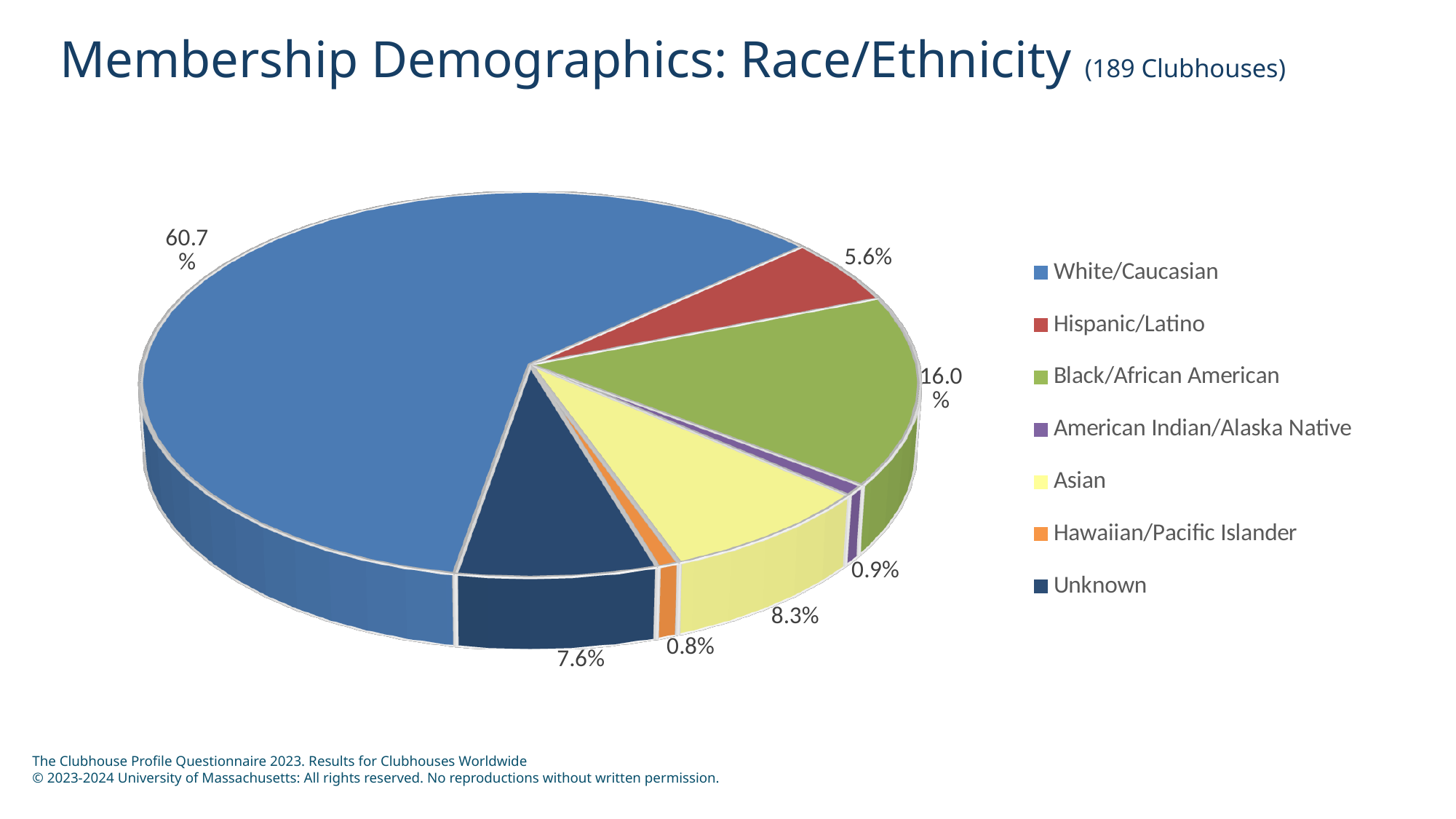
What percentage is shown for Hispanic/Latino? 5.6% Which category has the smallest slice of the pie? Hawaiian/Pacific Islander Which is larger, the Asian share or the Unknown share? Asian Which category has the largest slice of the pie? White/Caucasian What kind of chart is shown on the slide? Pie chart How many clubhouses does the chart title say the data covers? 189 What percentage is shown for Black/African American? 16.0% How many categories does the legend list? 7 What percentage is shown for Unknown? 7.6% What is the difference in percentage points between Black/African American and Hispanic/Latino? 10.4 What share of membership is White/Caucasian? 60.7% What percentage is shown for Asian? 8.3%